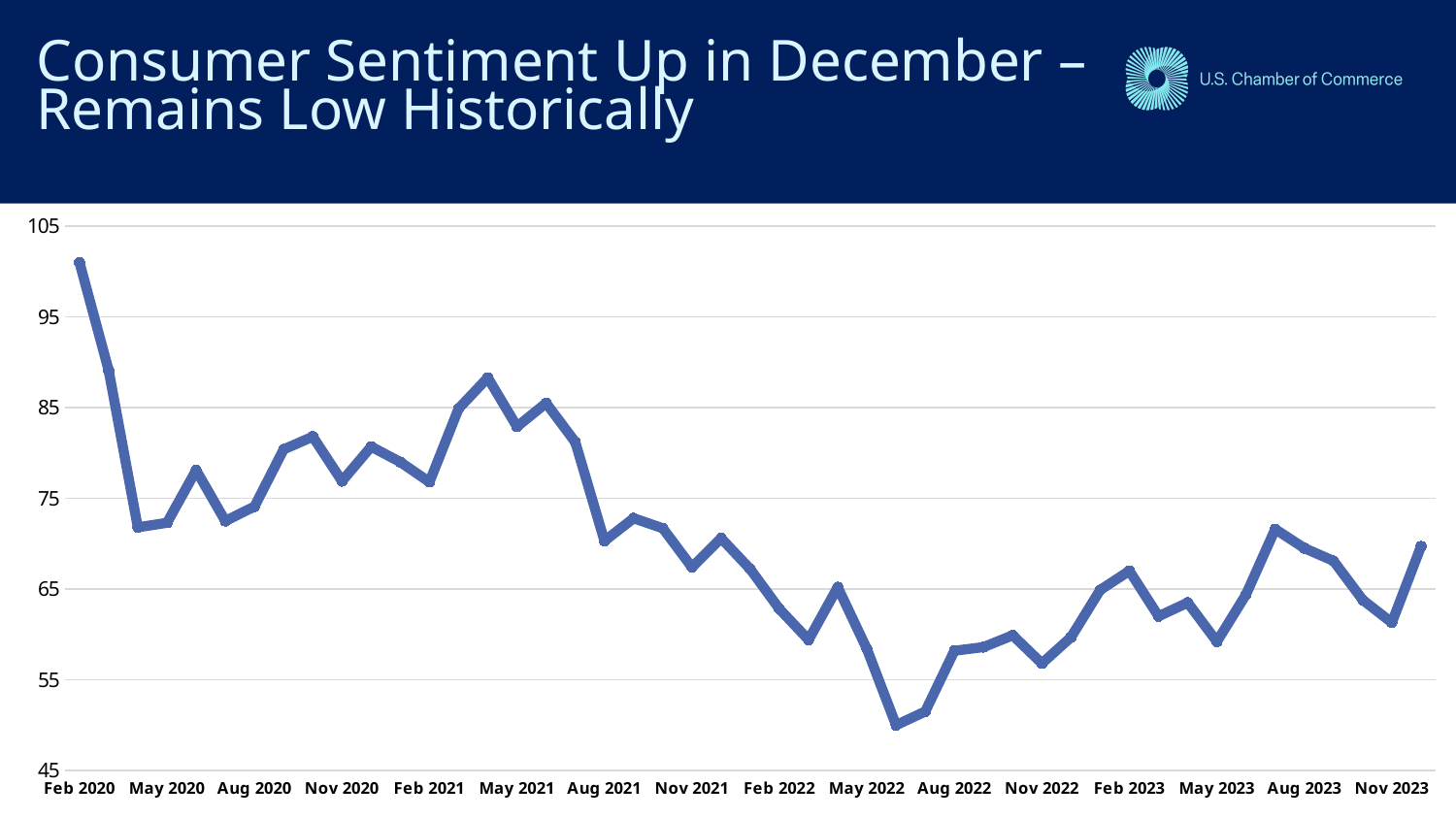
Is the value for May 2022 greater or less than 65? less How many lines are plotted on the chart? 1 Which is larger, the value for May 2021 or the value for May 2022? May 2021 What is the title of the slide? Consumer Sentiment Up in December – Remains Low Historically Is the value for Nov 2023 greater or less than 65? less How many month labels are shown along the x axis? 16 Which labeled month on the x axis has the highest consumer sentiment value? Feb 2020 What kind of chart is shown on the slide? line chart Is the value for Feb 2021 greater or less than 75? greater Overall, does consumer sentiment rise or fall from Feb 2020 to Nov 2023? fall